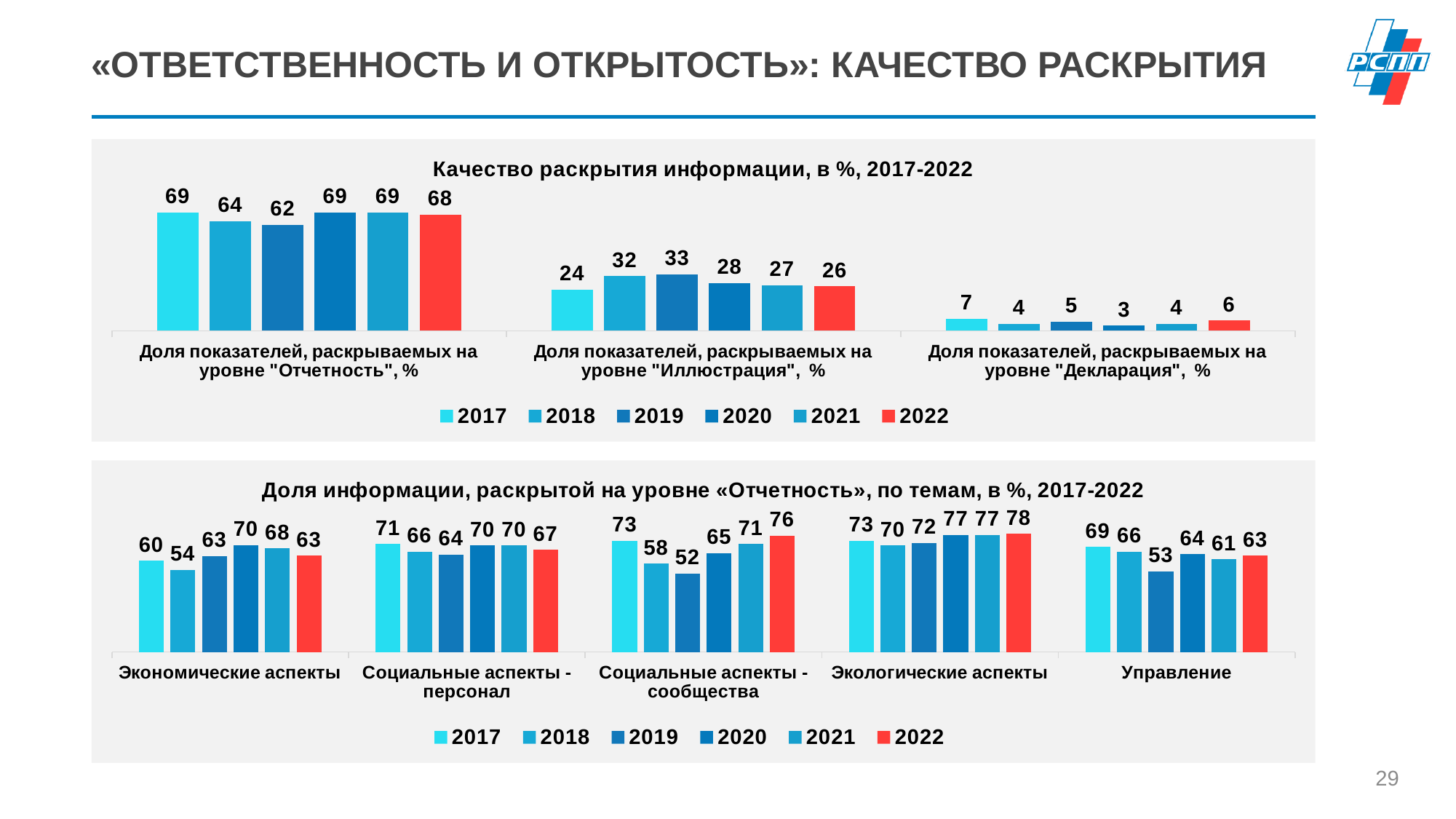
In the top chart "Качество раскрытия информации, в %, 2017-2022", how many categories are shown on the x axis? 3 In the top chart "Качество раскрытия информации, в %, 2017-2022", what is the difference between the 2017 and 2019 values for "Доля показателей, раскрываемых на уровне "Иллюстрация", %"? 9 In the top chart "Качество раскрытия информации, в %, 2017-2022", how many series does the legend list? 6 What kind of chart is the bottom chart "Доля информации, раскрытой на уровне «Отчетность», по темам, в %, 2017-2022"? Bar chart In the bottom chart "Доля информации, раскрытой на уровне «Отчетность», по темам, в %, 2017-2022", what is the 2022 value for "Экологические аспекты"? 78 In the bottom chart "Доля информации, раскрытой на уровне «Отчетность», по темам, в %, 2017-2022", which is larger for "Социальные аспекты - сообщества": the 2017 value or the 2022 value? 2022 In the top chart "Качество раскрытия информации, в %, 2017-2022", which year has the lowest value for "Доля показателей, раскрываемых на уровне "Отчетность", %"? 2019 In the bottom chart "Доля информации, раскрытой на уровне «Отчетность», по темам, в %, 2017-2022", what is the difference between the 2020 and 2018 values for "Экономические аспекты"? 16 In the top chart "Качество раскрытия информации, в %, 2017-2022", what is the 2022 value for "Доля показателей, раскрываемых на уровне "Декларация", %"? 6 In the bottom chart "Доля информации, раскрытой на уровне «Отчетность», по темам, в %, 2017-2022", which year has the lowest value for "Управление"? 2019 In the bottom chart "Доля информации, раскрытой на уровне «Отчетность», по темам, в %, 2017-2022", how many categories are shown on the x axis? 5 In the top chart "Качество раскрытия информации, в %, 2017-2022", what is the 2019 value for "Доля показателей, раскрываемых на уровне "Иллюстрация", %"? 33